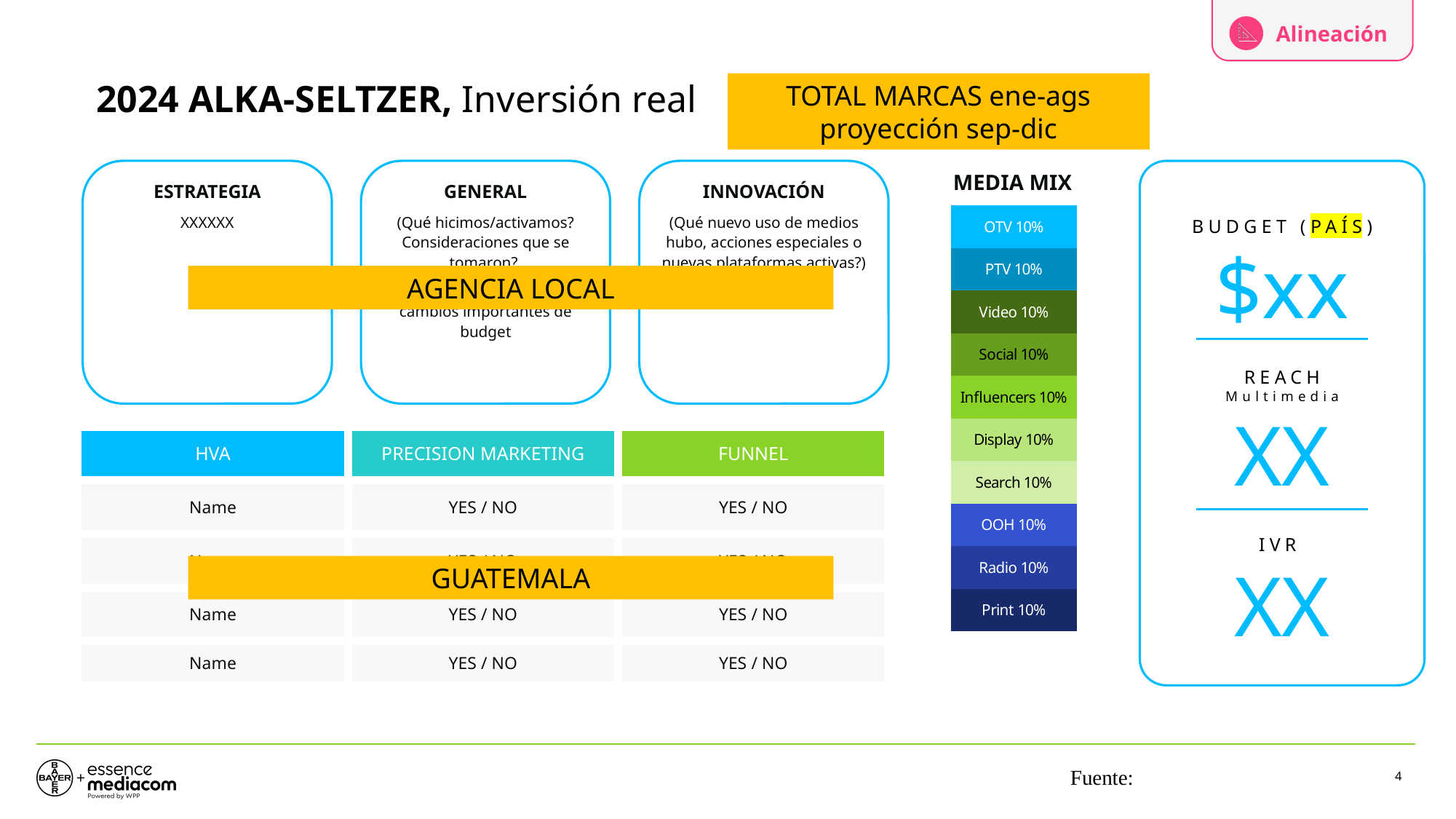
In the MEDIA MIX chart, what is the value for Influencers? 10% What is the title of the stacked bar chart on the slide? MEDIA MIX In the MEDIA MIX chart, what is the value for Search? 10% What kind of chart is the MEDIA MIX chart? Stacked bar chart In the MEDIA MIX chart, what is the value for OTV? 10% What is the total of all segments in the MEDIA MIX chart? 100% How many segments does the MEDIA MIX chart contain? 10 In the MEDIA MIX chart, what is the value for Print? 10% Which segment is at the top of the MEDIA MIX chart? OTV What is the difference between the OTV and Print values in the MEDIA MIX chart? 0% In the MEDIA MIX chart, what is the value for Radio? 10%